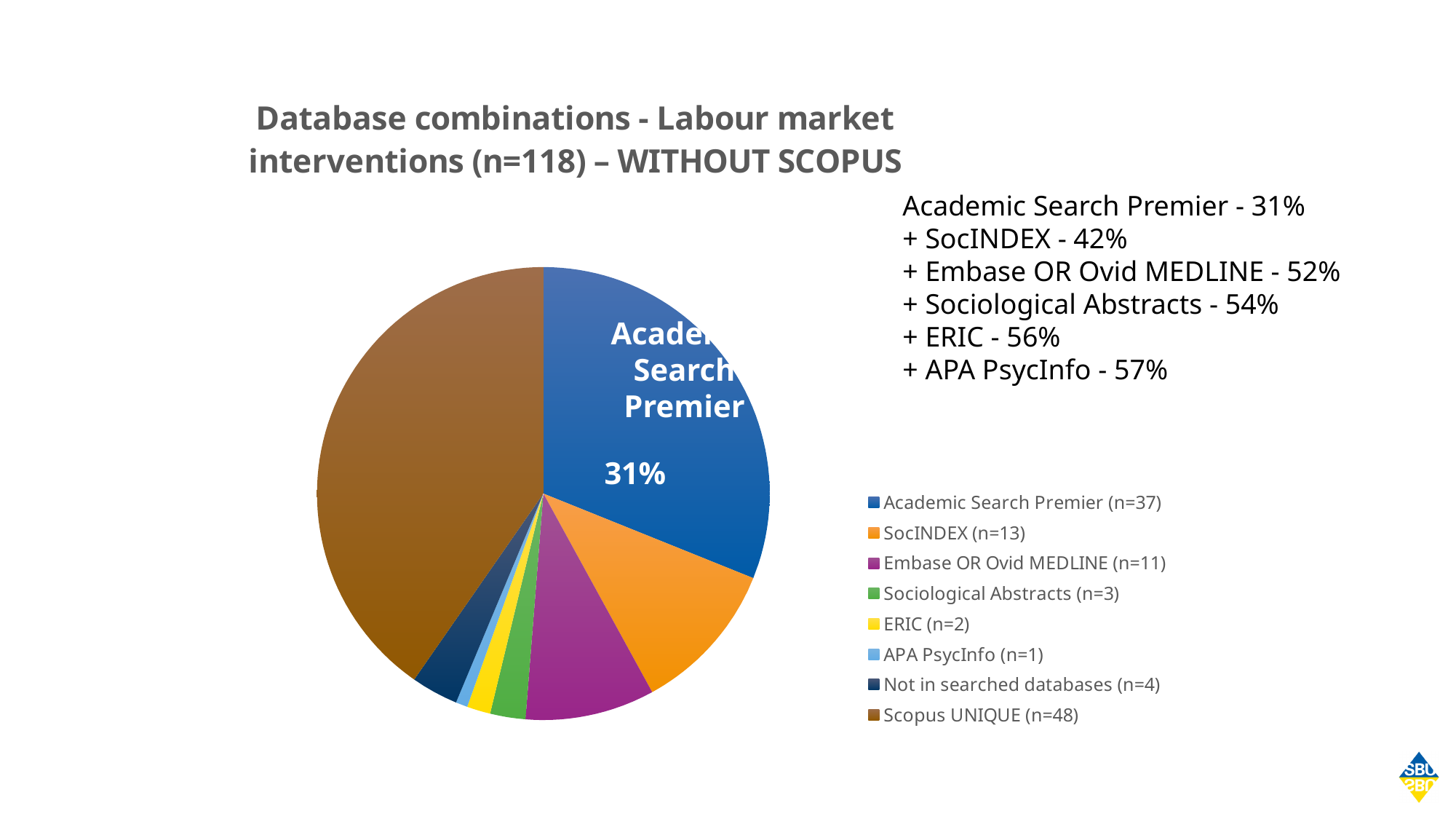
Which slice is larger: SocINDEX or Embase OR Ovid MEDLINE? SocINDEX Which category has the smallest slice of the pie? APA PsycInfo (n=1) Which category has the largest slice of the pie? Scopus UNIQUE (n=48) According to the legend, what is the n value for SocINDEX? 13 Which slice is larger: Scopus UNIQUE or Academic Search Premier? Scopus UNIQUE What percentage is labelled on the Academic Search Premier slice? 31% What kind of chart is shown on the slide? pie chart What colour is the Scopus UNIQUE slice? brown How many slices does the pie chart have? 8 What is the difference between the n values of Scopus UNIQUE and Academic Search Premier shown in the legend? 11 What share of the pie does Academic Search Premier represent? 31% According to the legend, what is the n value for Not in searched databases? 4